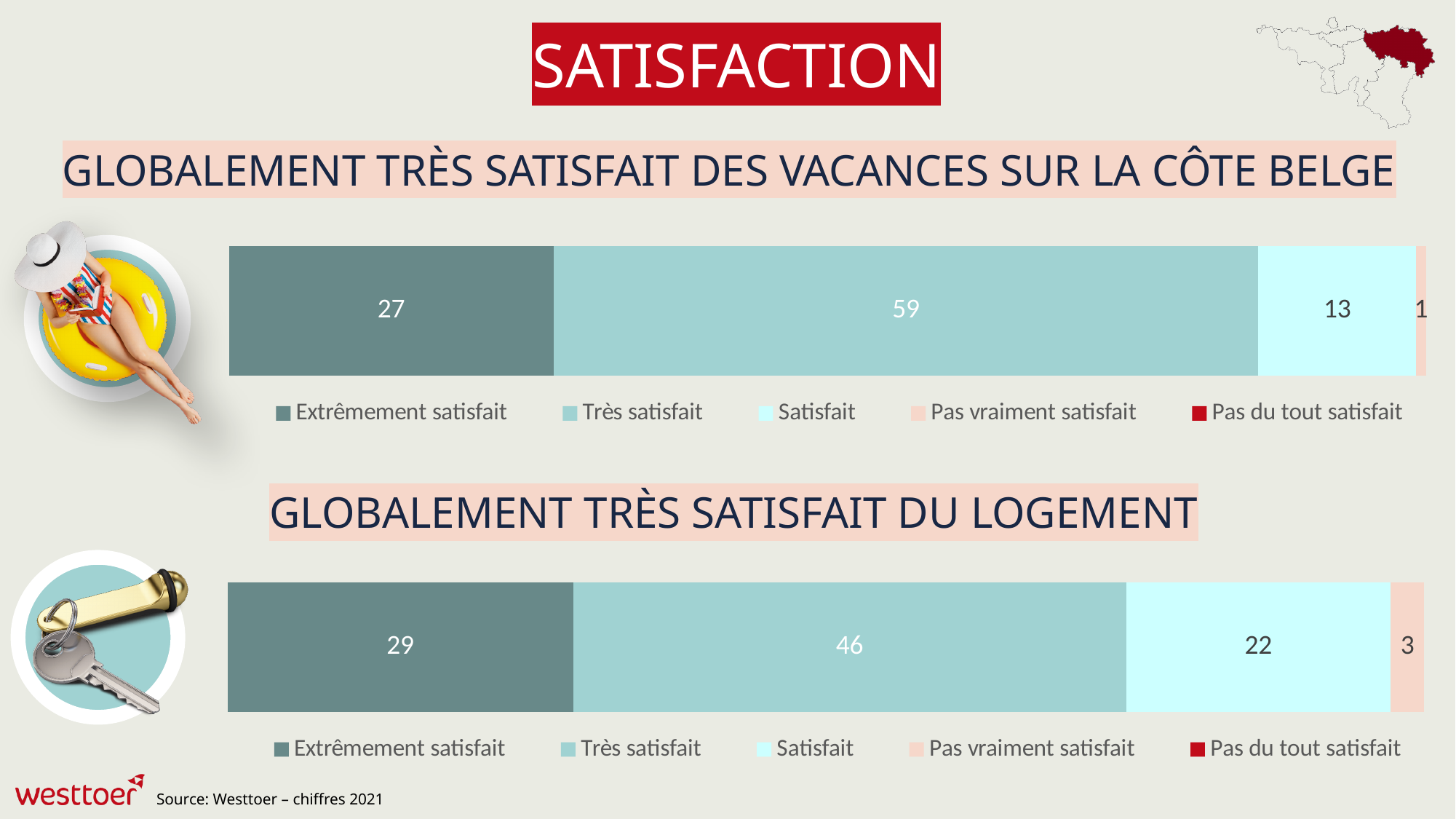
In the chart 'Globalement très satisfait des vacances sur la côte belge', which category has the highest value? Très satisfait What kind of chart is 'Globalement très satisfait du logement'? Stacked bar chart Which is larger: 'Satisfait' in the chart 'Globalement très satisfait des vacances sur la côte belge' or 'Satisfait' in the chart 'Globalement très satisfait du logement'? Globalement très satisfait du logement In the chart 'Globalement très satisfait du logement', which labelled category has the lowest value? Pas vraiment satisfait How many series does the legend of the chart 'Globalement très satisfait des vacances sur la côte belge' list? 5 In the chart 'Globalement très satisfait des vacances sur la côte belge', what is the value for 'Extrêmement satisfait'? 27 In the chart 'Globalement très satisfait du logement', what is the value for 'Pas vraiment satisfait'? 3 In the chart 'Globalement très satisfait du logement', which legend entry is shown in red? Pas du tout satisfait In the chart 'Globalement très satisfait du logement', what is the difference between 'Très satisfait' and 'Extrêmement satisfait'? 17 In the chart 'Globalement très satisfait des vacances sur la côte belge', what is the value for 'Très satisfait'? 59 In the chart 'Globalement très satisfait du logement', what is the value for 'Satisfait'? 22 What is the total of the labelled segments in the bar of the chart 'Globalement très satisfait des vacances sur la côte belge'? 100